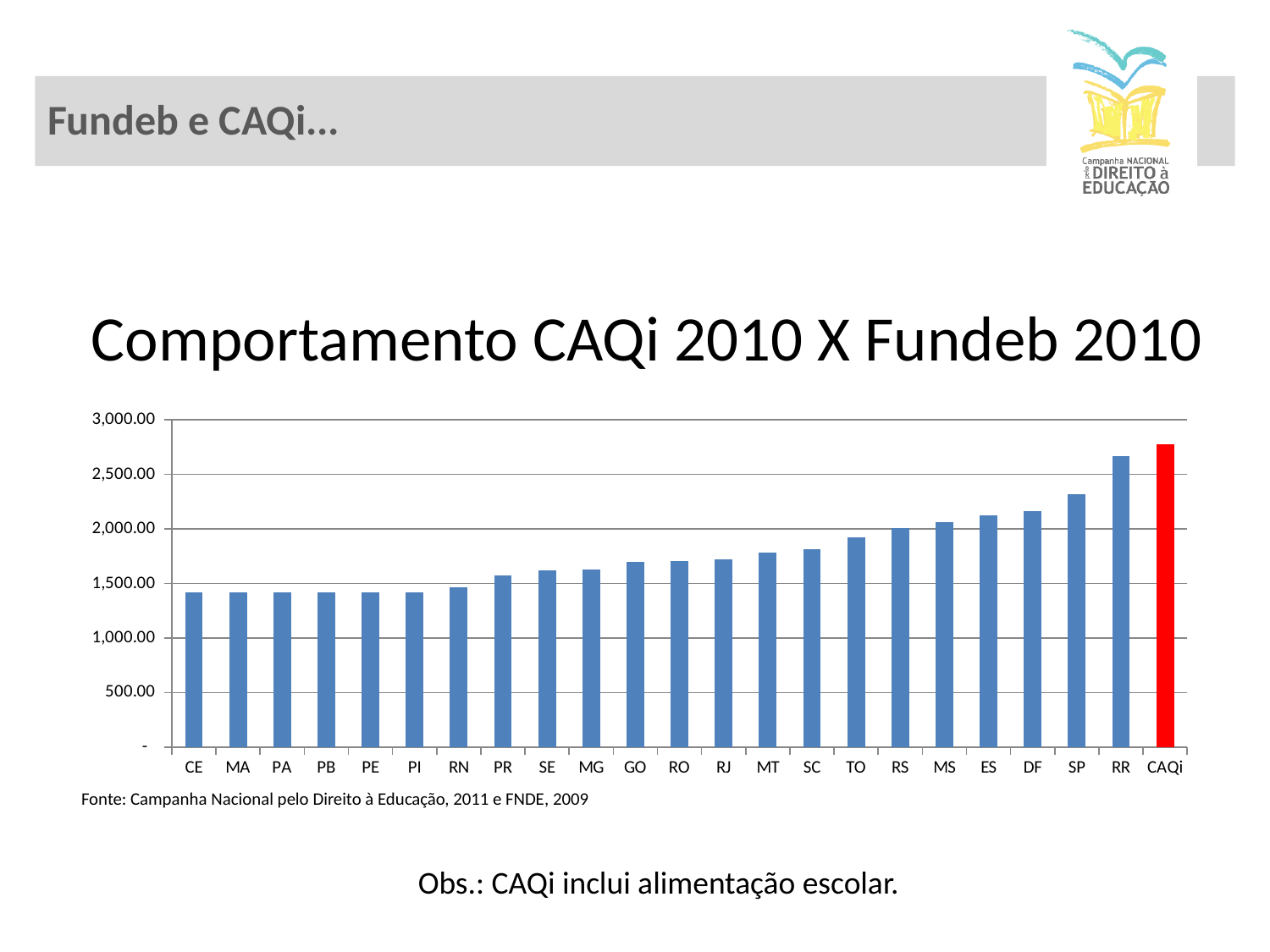
What kind of chart is shown on the slide? bar chart Which category has the highest bar in the chart? CAQi Is the value for PR greater or less than 1,500.00? greater Is the value for CE greater or less than 1,500.00? less Which is larger, the value for CAQi or the value for RR? CAQi Do the bar values generally rise or fall from left to right along the x axis? rise What colour is the bar for CAQi? red Which is larger, the value for RR or the value for SP? RR Is the value for SP greater or less than 2,000.00? greater How many categories are plotted along the x axis of the chart? 23